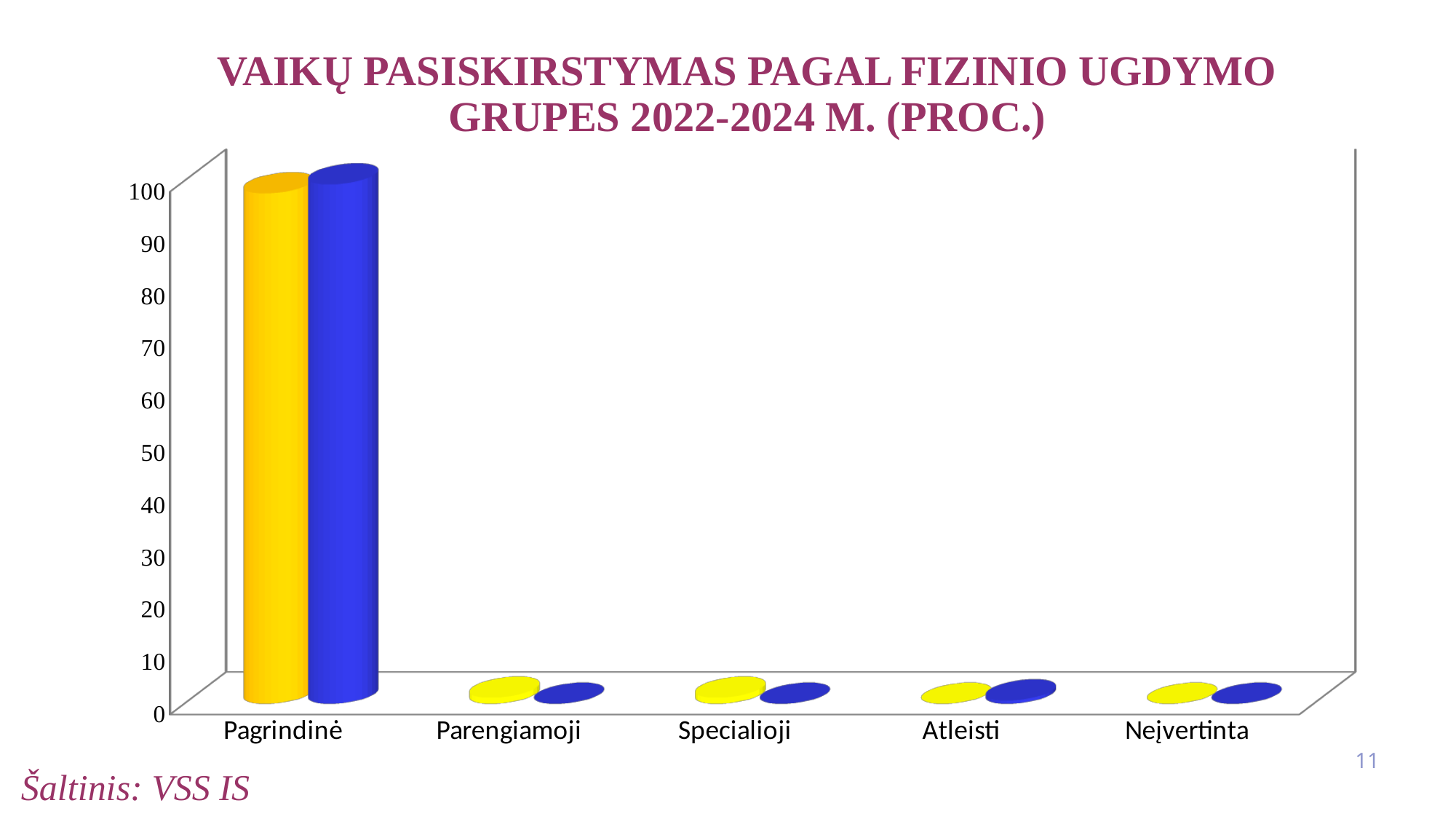
Is the value of the yellow bar for Parengiamoji greater or less than 10? less Is the value of the yellow bar for Neįvertinta greater or less than 20? less What source is cited below the chart? VSS IS Is the value of the yellow bar for Pagrindinė greater or less than 90? greater How many categories are shown on the x axis of the chart? 5 Which category has the highest values in the chart? Pagrindinė What kind of chart is shown on the slide? bar chart Do the values fall or rise going from Pagrindinė to Neįvertinta along the x axis? fall What is the title of the chart? VAIKŲ PASISKIRSTYMAS PAGAL FIZINIO UGDYMO GRUPES 2022-2024 M. (PROC.) Which category has the larger values, Pagrindinė or Specialioji? Pagrindinė